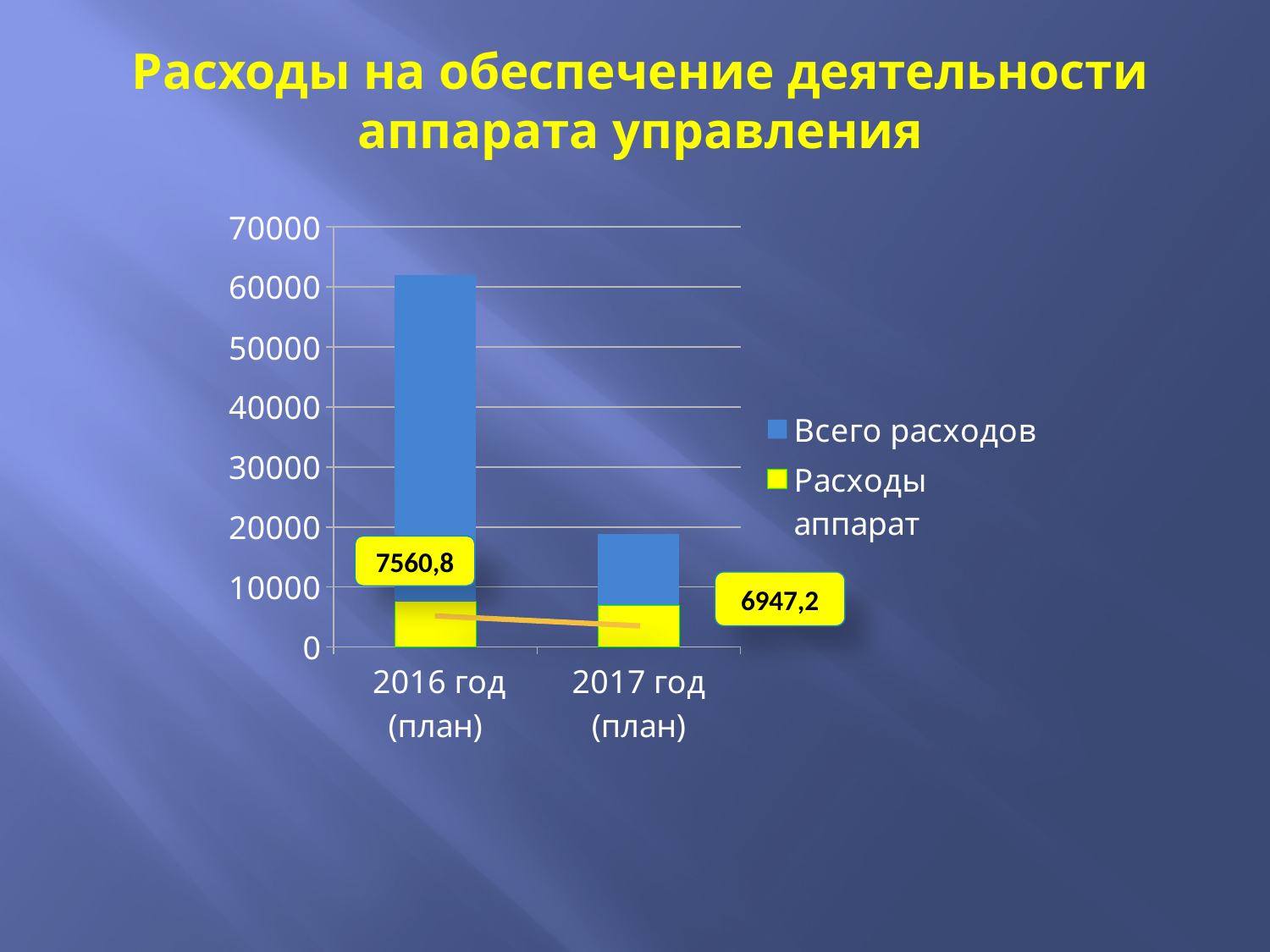
Is the Всего расходов bar for 2017 год (план) greater or less than 30000? less What colour represents the Всего расходов series in the legend? blue Do the Расходы аппарат values rise or fall from 2016 год (план) to 2017 год (план)? fall How many categories are shown on the x axis? 2 How many series does the legend list? 2 What is the difference between the Расходы аппарат values for 2016 год (план) and 2017 год (план)? 613,6 Is the Всего расходов bar for 2016 год (план) greater or less than 50000? greater What is the value of Расходы аппарат for 2017 год (план)? 6947,2 Which category has the highest Всего расходов bar? 2016 год (план) What kind of chart is shown on the slide? bar chart What is the value of Расходы аппарат for 2016 год (план)? 7560,8 Which year has the higher Расходы аппарат value, 2016 год (план) or 2017 год (план)? 2016 год (план)